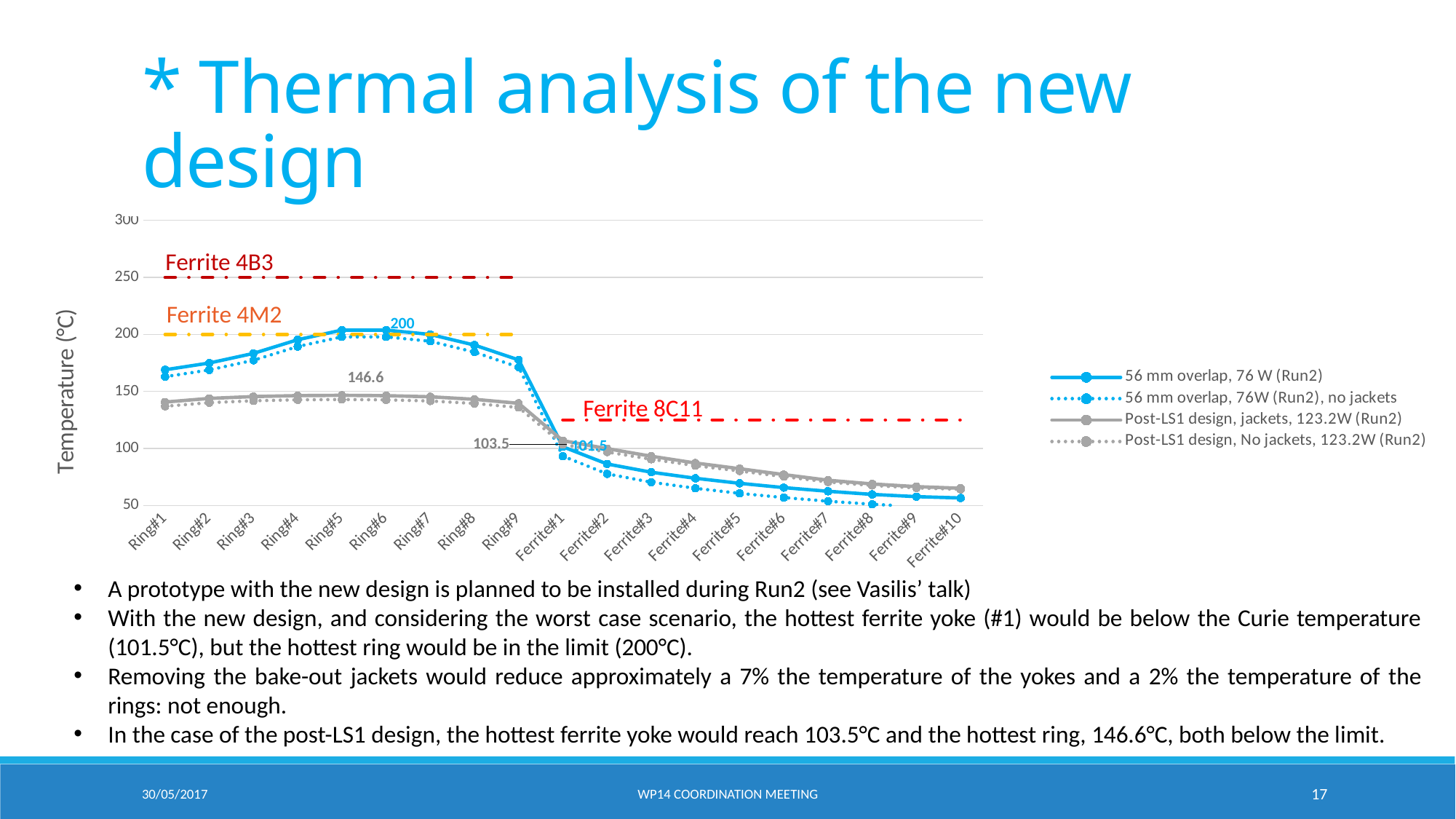
Which series reaches the highest temperature on the chart? 56 mm overlap, 76 W (Run2) How many categories are shown along the x axis of the chart? 19 What is the labelled peak value of the 'Post-LS1 design, jackets, 123.2W (Run2)' series among the rings? 146.6 What is the label of the y axis of the chart? Temperature (°C) What kind of chart is shown on the slide? line chart What is the labelled peak value of the '56 mm overlap, 76 W (Run2)' series? 200 Is the value of the '56 mm overlap, 76 W (Run2)' series at Ring#1 greater or less than 150? greater What is the difference between the labelled peak ring values 200 and 146.6? 53.4 What is the labelled value of the '56 mm overlap, 76 W (Run2)' series at Ferrite#1? 101.5 How many series does the chart legend list? 4 Do the values of the '56 mm overlap, 76 W (Run2)' series rise or fall from Ferrite#1 to Ferrite#10? fall